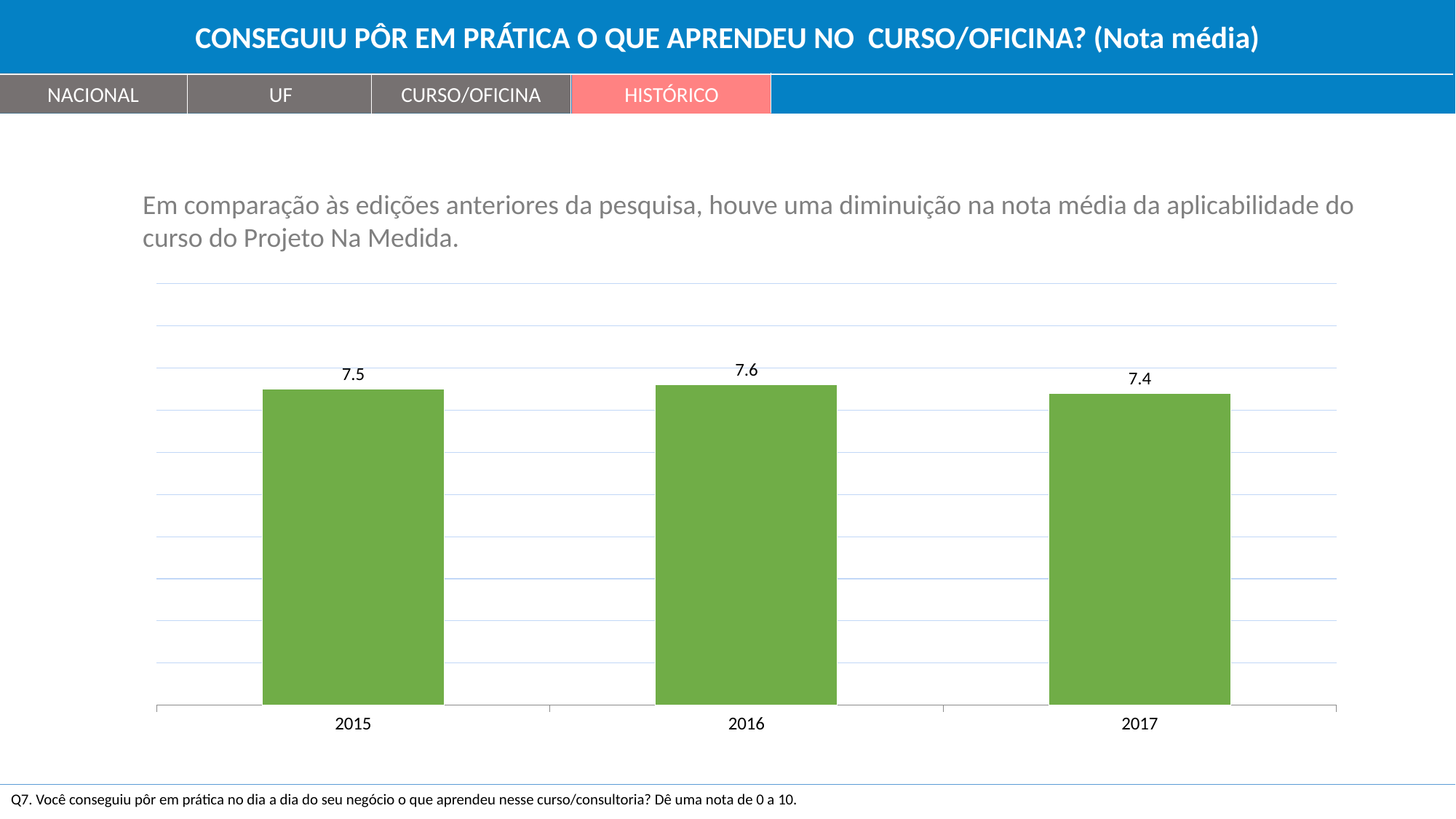
Which year has the lowest average score? 2017 What kind of chart is shown on the slide? Bar chart What is the average score for 2016? 7.6 Which year has the highest average score? 2016 What is the difference between the 2016 and 2017 average scores? 0.2 What is the average score for 2015? 7.5 Which year has a higher average score, 2015 or 2016? 2016 What is the difference between the 2015 and 2017 average scores? 0.1 What colour are the bars in the chart? Green Does the average score rise or fall from 2016 to 2017? Fall What is the average score for 2017? 7.4 How many years are shown on the chart? 3